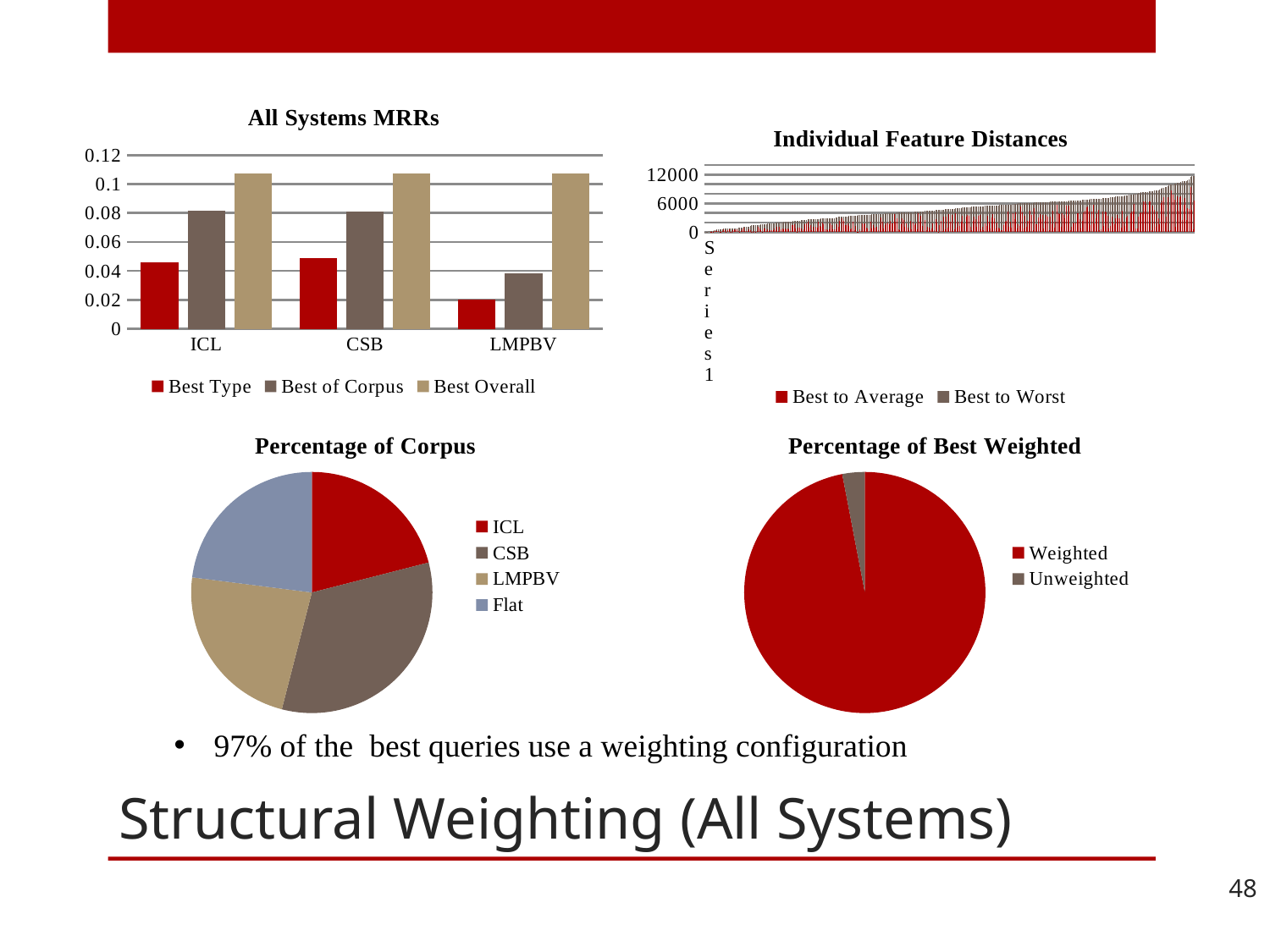
In the 'All Systems MRRs' chart, is the Best of Corpus value for ICL greater or less than 0.06? greater What kind of chart is 'Individual Feature Distances'? bar chart In the 'Percentage of Corpus' pie chart, how many slices are there? 4 In the 'Individual Feature Distances' chart, how many series does the legend list? 2 In the 'All Systems MRRs' chart, is the Best Overall value for CSB greater or less than 0.1? greater In the 'Individual Feature Distances' chart, do the values rise or fall along the x axis? rise In the 'All Systems MRRs' chart, how many categories are shown on the x axis? 3 In the 'All Systems MRRs' chart, which category has the lowest Best Type value? LMPBV In the 'All Systems MRRs' chart, is the Best Type value for LMPBV greater or less than 0.04? less In the 'Percentage of Best Weighted' pie chart, which slice is the largest? Weighted In the 'All Systems MRRs' chart, for ICL, which is larger: Best Type or Best of Corpus? Best of Corpus In the 'All Systems MRRs' chart, how many series does the legend list? 3